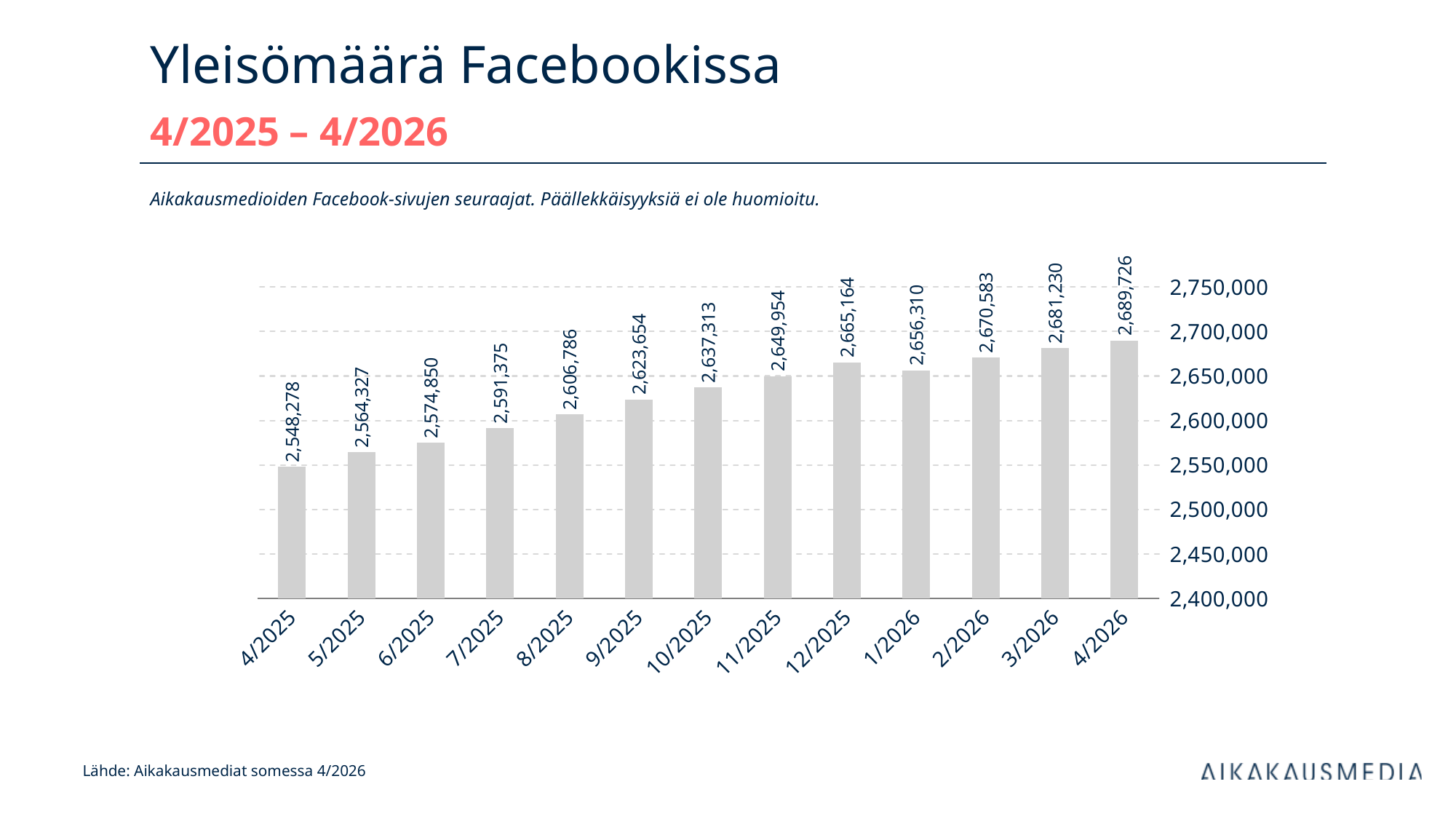
What is the value for 1/2026? 2,656,310 What kind of chart is shown on the slide? bar chart What is the value for 4/2025? 2,548,278 What is the difference between the values for 4/2026 and 4/2025? 141,448 Which month has the lowest value? 4/2025 What is the value for 12/2025? 2,665,164 What is the difference between the values for 12/2025 and 1/2026? 8,854 How many months are shown on the x axis? 13 Which month has the highest value? 4/2026 Is the value for 8/2025 greater or less than 2,600,000? greater What is the title of the chart on the slide? Yleisömäärä Facebookissa Which is larger, the value for 12/2025 or the value for 1/2026? 12/2025